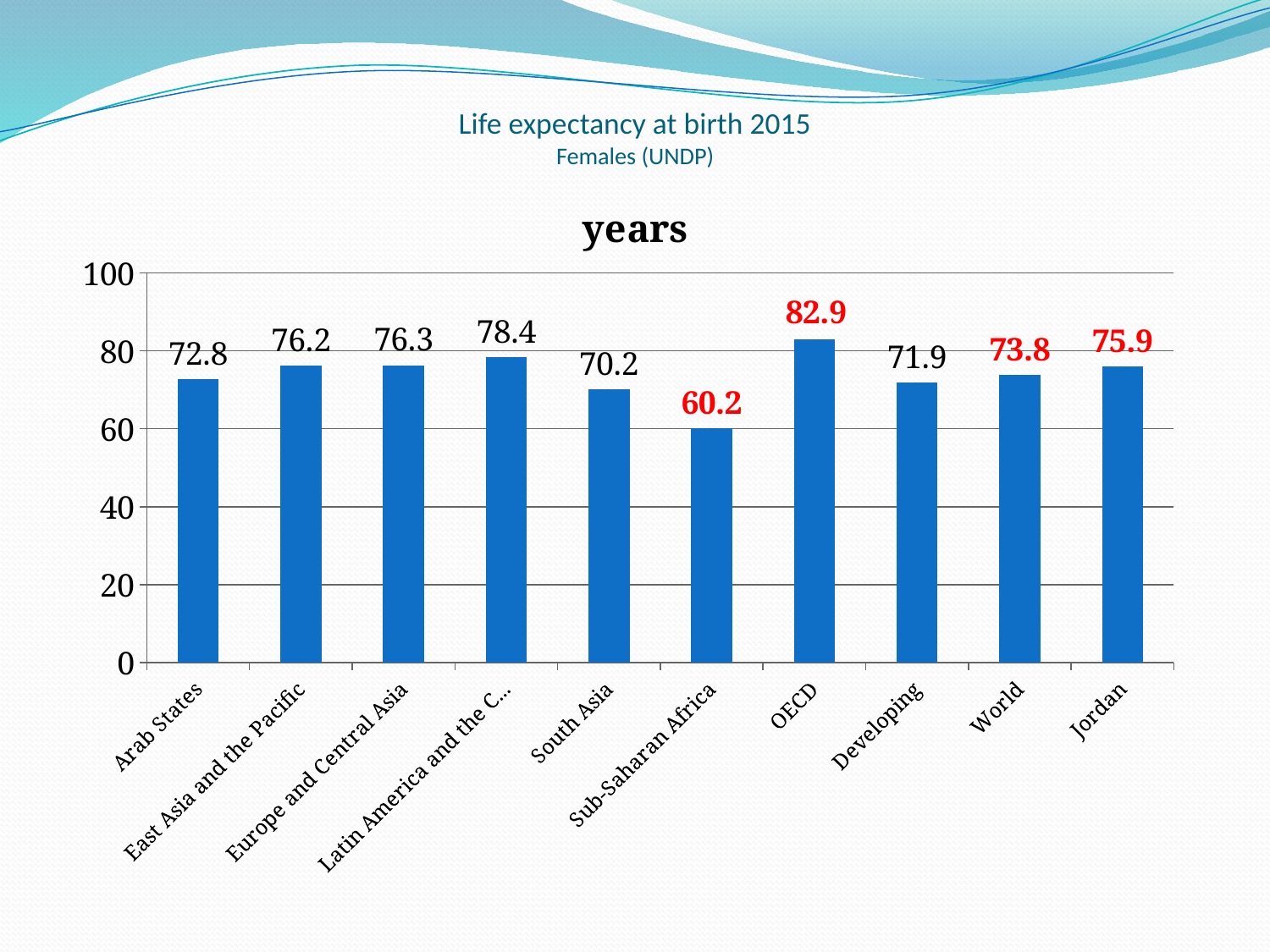
What is the life expectancy value for Jordan? 75.9 What kind of chart is shown on the slide? bar chart Which category has the lowest value? Sub-Saharan Africa What is the value shown for South Asia? 70.2 What is the value shown for Sub-Saharan Africa? 60.2 What is the difference between the OECD value and the Sub-Saharan Africa value? 22.7 What is the difference between the Jordan value and the World value? 2.1 Which is larger, the value for Arab States or the value for Developing? Arab States How many categories are shown on the x axis? 10 Which category has the highest value? OECD What is the value shown for the World? 73.8 Is the value for Sub-Saharan Africa greater or less than 80? less